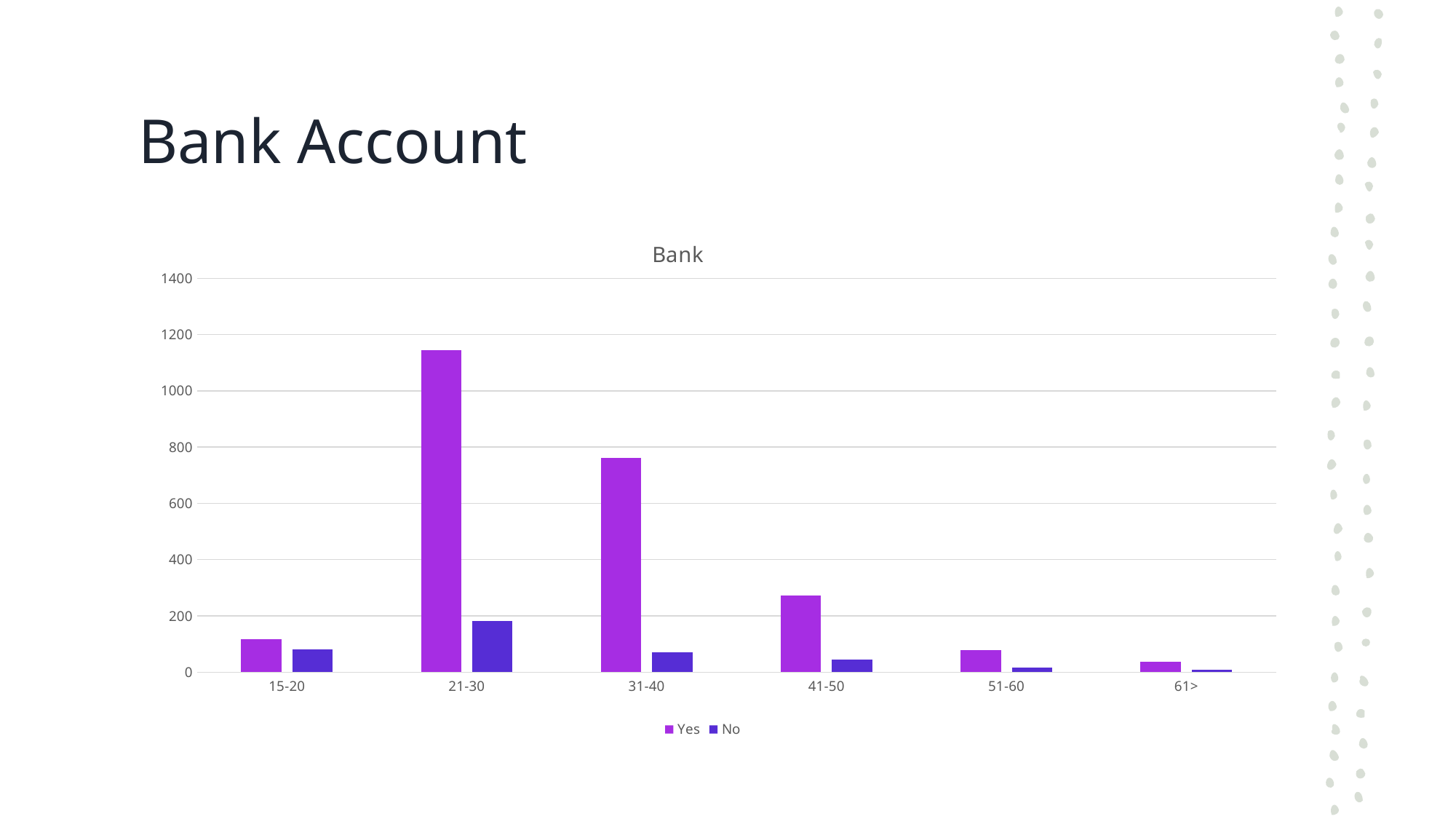
What kind of chart is shown on the slide? bar chart Is the Yes value for 21-30 greater or less than 1000? greater How many series does the legend list? 2 Which age group has the highest Yes value? 21-30 Is the Yes value for 31-40 greater or less than 800? less Which is larger, the No value for 21-30 or the No value for 41-50? 21-30 Which age group has the lowest Yes value? 61> Is the Yes value for 41-50 greater or less than 200? greater What is the title of the chart? Bank How many age-group categories are shown on the x axis? 6 Which age group has the highest No value? 21-30 For the 31-40 age group, which is larger, Yes or No? Yes